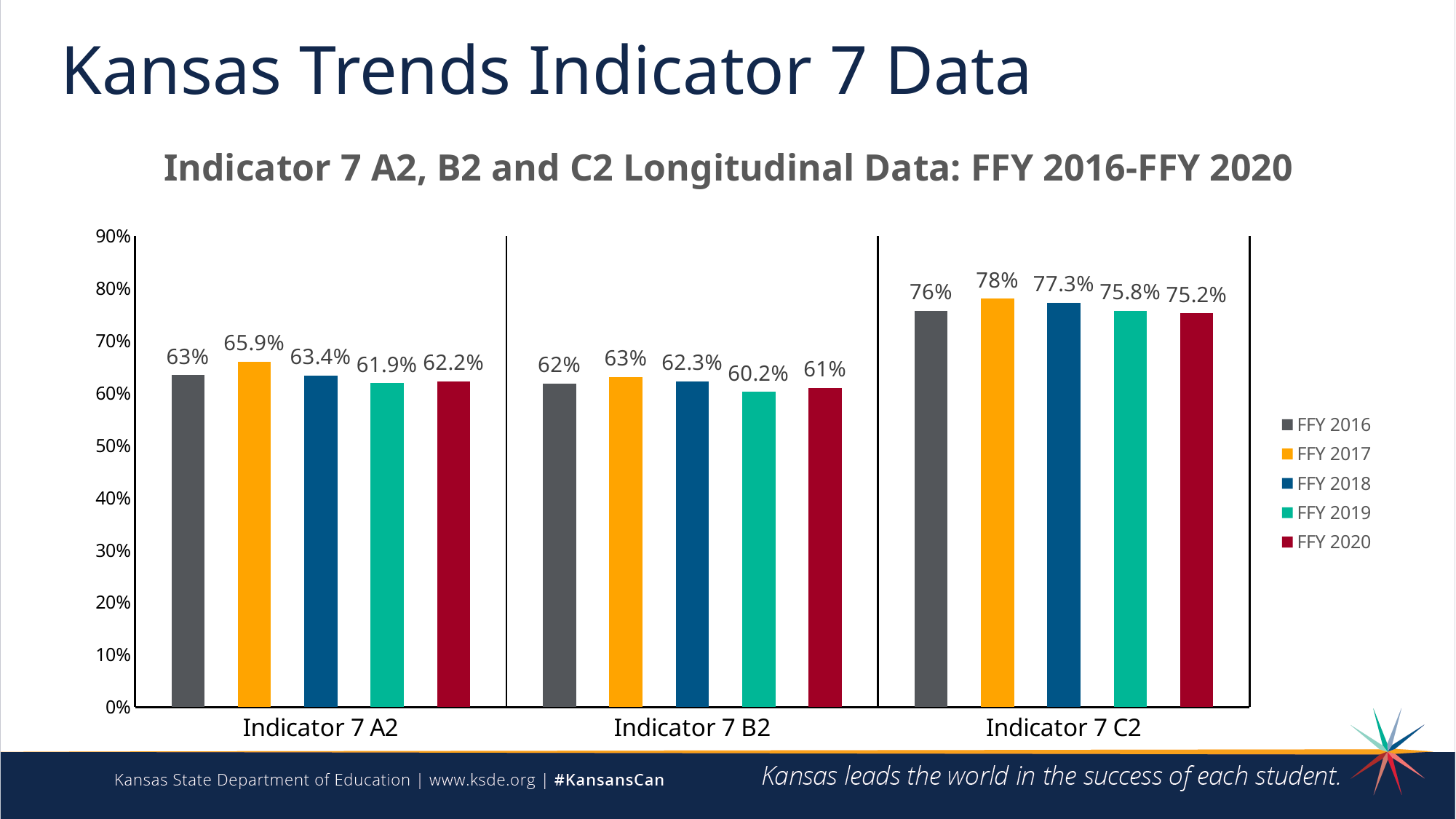
What is the title of the chart? Indicator 7 A2, B2 and C2 Longitudinal Data: FFY 2016-FFY 2020 What is the difference between the FFY 2017 and FFY 2016 values for Indicator 7 C2? 2% What is the FFY 2018 value for Indicator 7 C2? 77.3% How many series does the legend list? 5 Which is larger: the FFY 2020 value for Indicator 7 A2 or the FFY 2020 value for Indicator 7 B2? Indicator 7 A2 Which year has the lowest value for Indicator 7 B2? FFY 2019 What is the FFY 2017 value for Indicator 7 A2? 65.9% What is the FFY 2019 value for Indicator 7 B2? 60.2% How many indicator categories are shown on the x axis? 3 Which year has the highest value for Indicator 7 C2? FFY 2017 What kind of chart is shown on the slide? Bar chart Is the FFY 2016 value for Indicator 7 C2 greater or less than 70%? greater